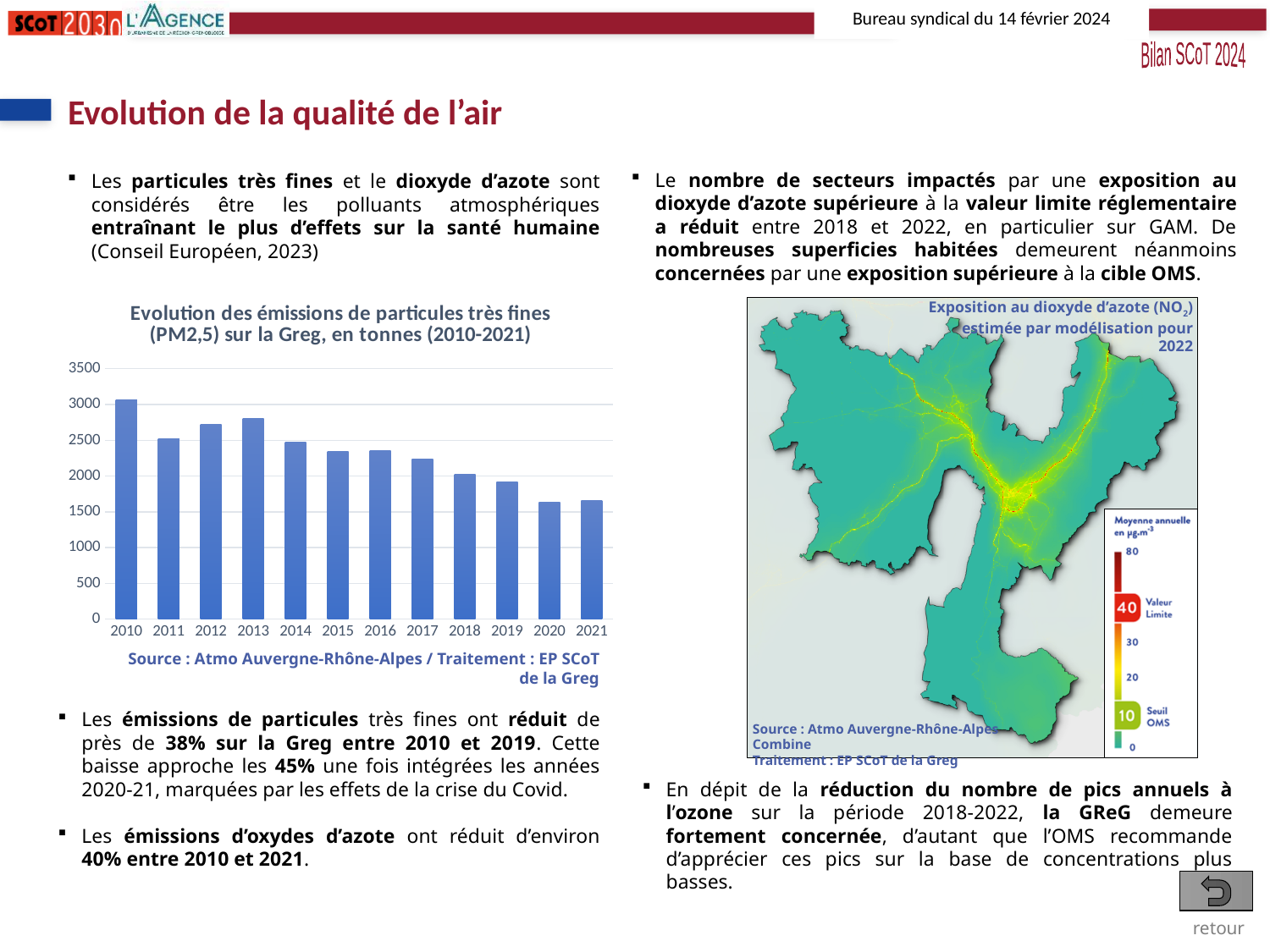
Do the PM2,5 emissions generally rise or fall from 2010 to 2021? fall Is the value for 2015 greater or less than 2500? less How many years are plotted in the bar chart? 12 Which year has the highest PM2,5 emissions in the bar chart? 2010 Which is larger, the value for 2010 or the value for 2021? 2010 Which is larger, the value for 2012 or the value for 2013? 2013 Is the value for 2021 greater or less than 1500? greater What kind of chart is shown on the slide? bar chart What is the title of the bar chart? Evolution des émissions de particules très fines (PM2,5) sur la Greg, en tonnes (2010-2021) Is the value for 2013 greater or less than 3000? less